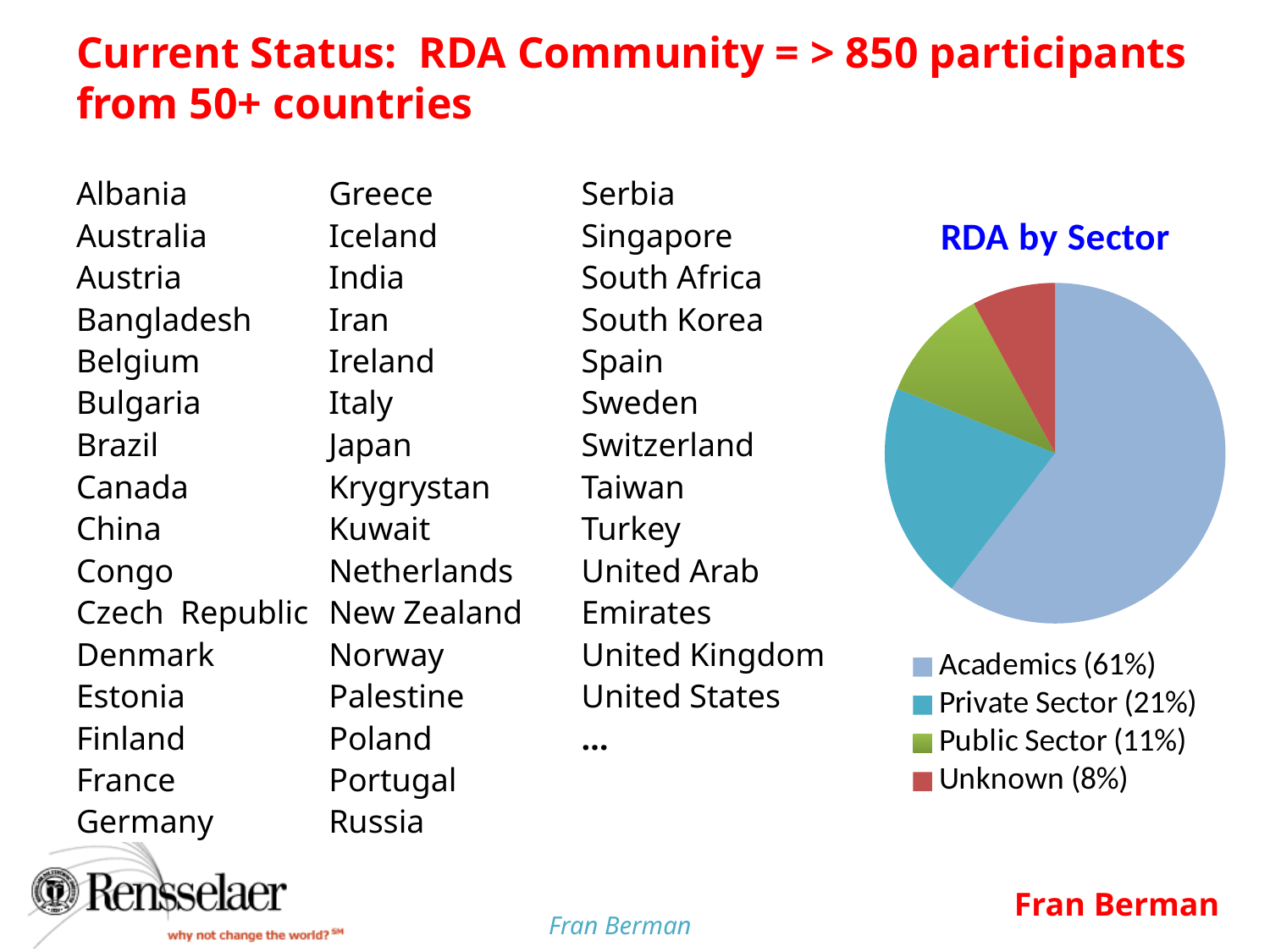
What kind of chart is the 'RDA by Sector' chart? pie chart What share of the pie does Public Sector account for? 11% How many slices does the 'RDA by Sector' pie chart have? 4 Which colour represents Private Sector in the pie chart? teal/light blue What is the difference in percentage points between the Academics share and the Private Sector share? 40 Which is larger, the Public Sector share or the Unknown share? Public Sector Which sector has the largest share of the pie? Academics Which sector has the smallest share of the pie? Unknown What share of the pie does Unknown account for? 8% What is the title of the pie chart? RDA by Sector What share of the pie does Academics account for? 61%